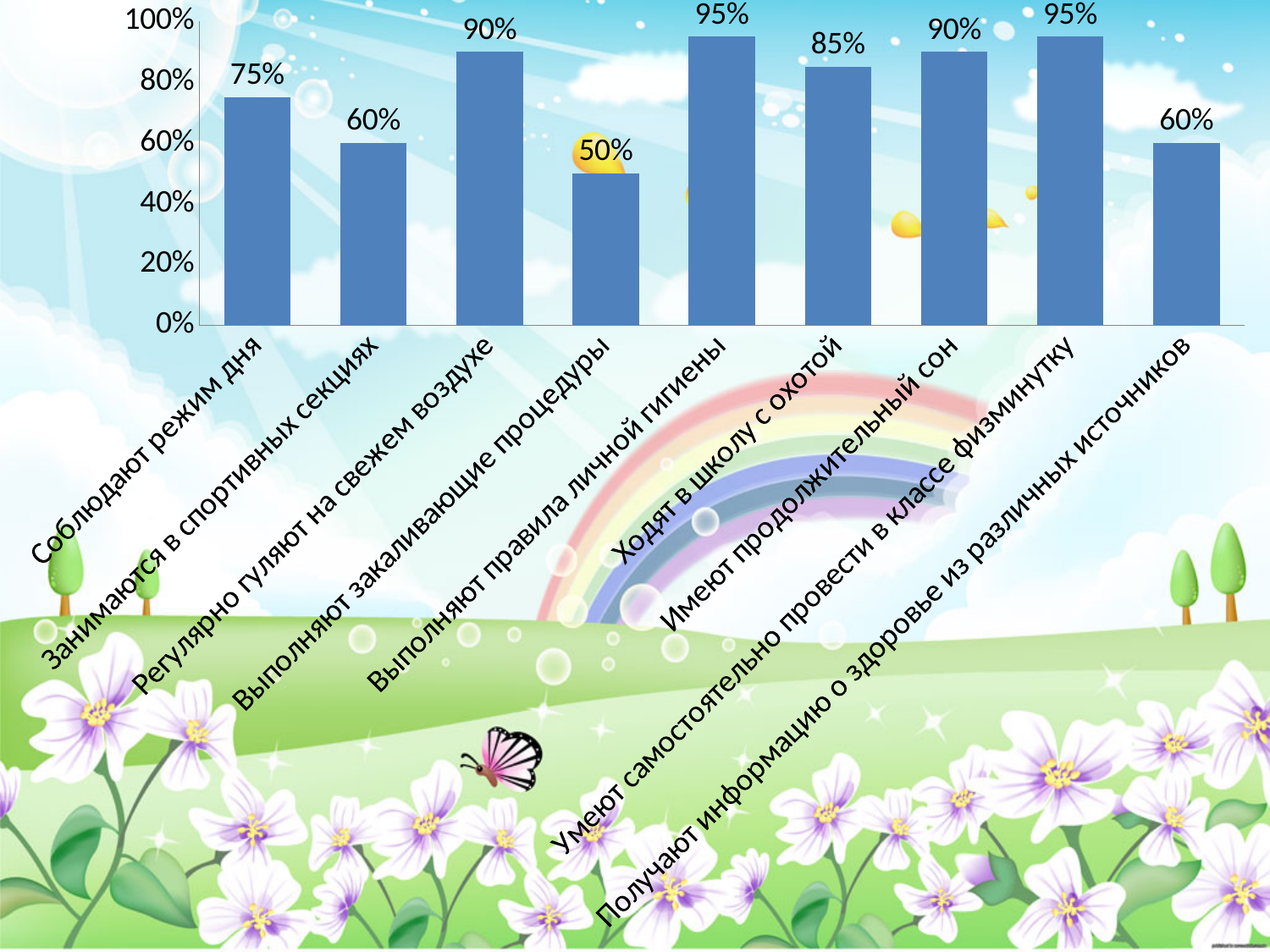
What kind of chart is shown on the slide? bar chart What is the value for «Имеют продолжительный сон»? 90% What is the value for «Ходят в школу с охотой»? 85% What is the difference between «Умеют самостоятельно провести в классе физминутку» and «Получают информацию о здоровье из различных источников»? 35% How many categories are shown in the chart? 9 What is the difference between «Выполняют правила личной гигиены» and «Занимаются в спортивных секциях»? 35% What is the value for «Соблюдают режим дня»? 75% What is the highest value shown on the vertical axis? 100% Is the value for «Соблюдают режим дня» greater or less than 80%? less Which category has the lowest value? Выполняют закаливающие процедуры Which is larger: «Регулярно гуляют на свежем воздухе» or «Ходят в школу с охотой»? Регулярно гуляют на свежем воздухе What is the value for «Выполняют закаливающие процедуры»? 50%